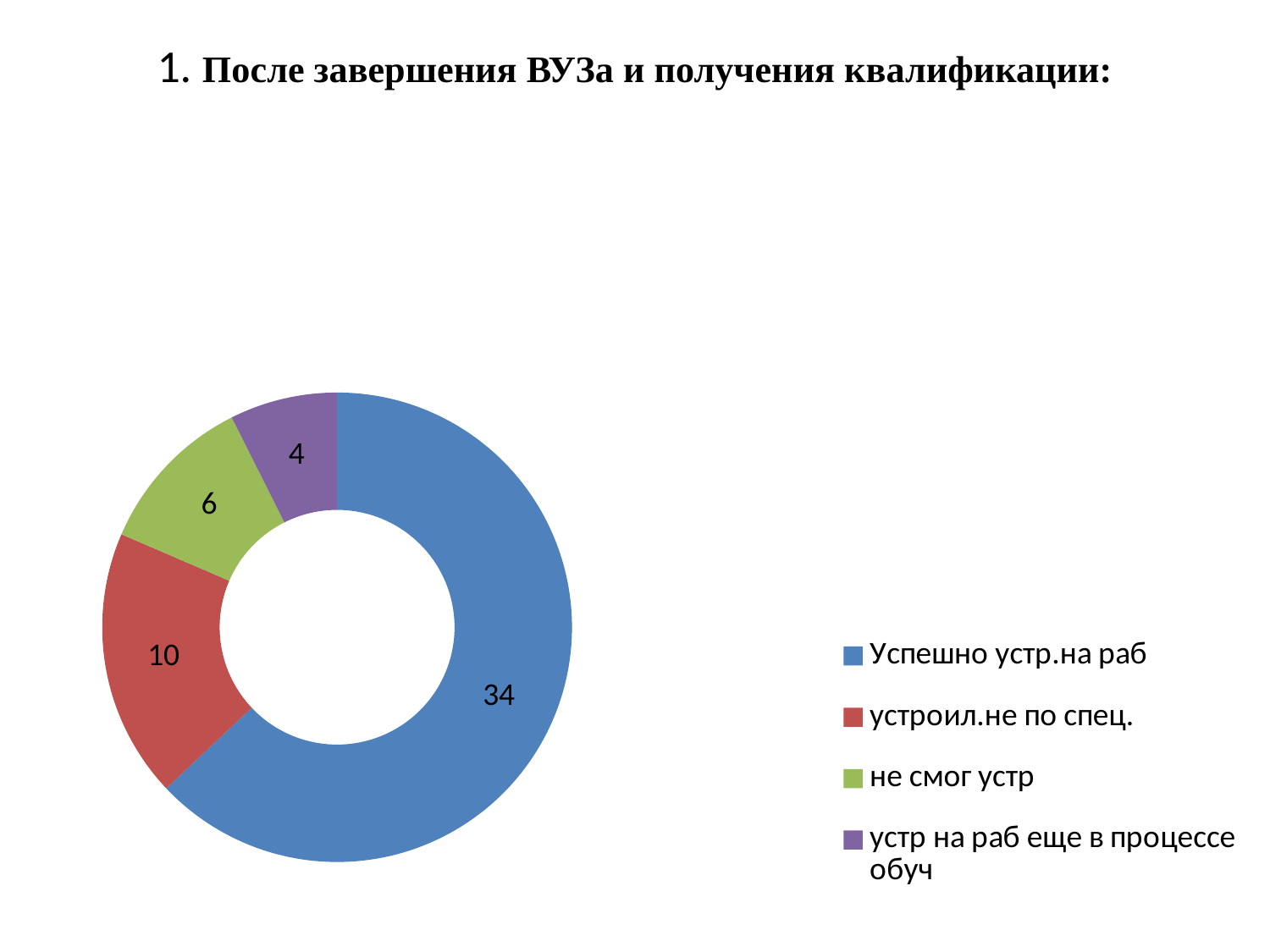
What colour is the segment for "устроил.не по спец."? red What is the value for "устроил.не по спец."? 10 What is the value for "устр на раб еще в процессе обуч"? 4 What is the total of all values in the chart? 54 Which category has the smallest value? устр на раб еще в процессе обуч How many categories does the chart show? 4 What is the value for "не смог устр"? 6 Which category has the largest value? Успешно устр.на раб What kind of chart is shown on the slide? doughnut chart What is the difference between the values for "Успешно устр.на раб" and "устроил.не по спец."? 24 What is the value for "Успешно устр.на раб"? 34 Which is larger: the value for "не смог устр" or the value for "устр на раб еще в процессе обуч"? не смог устр